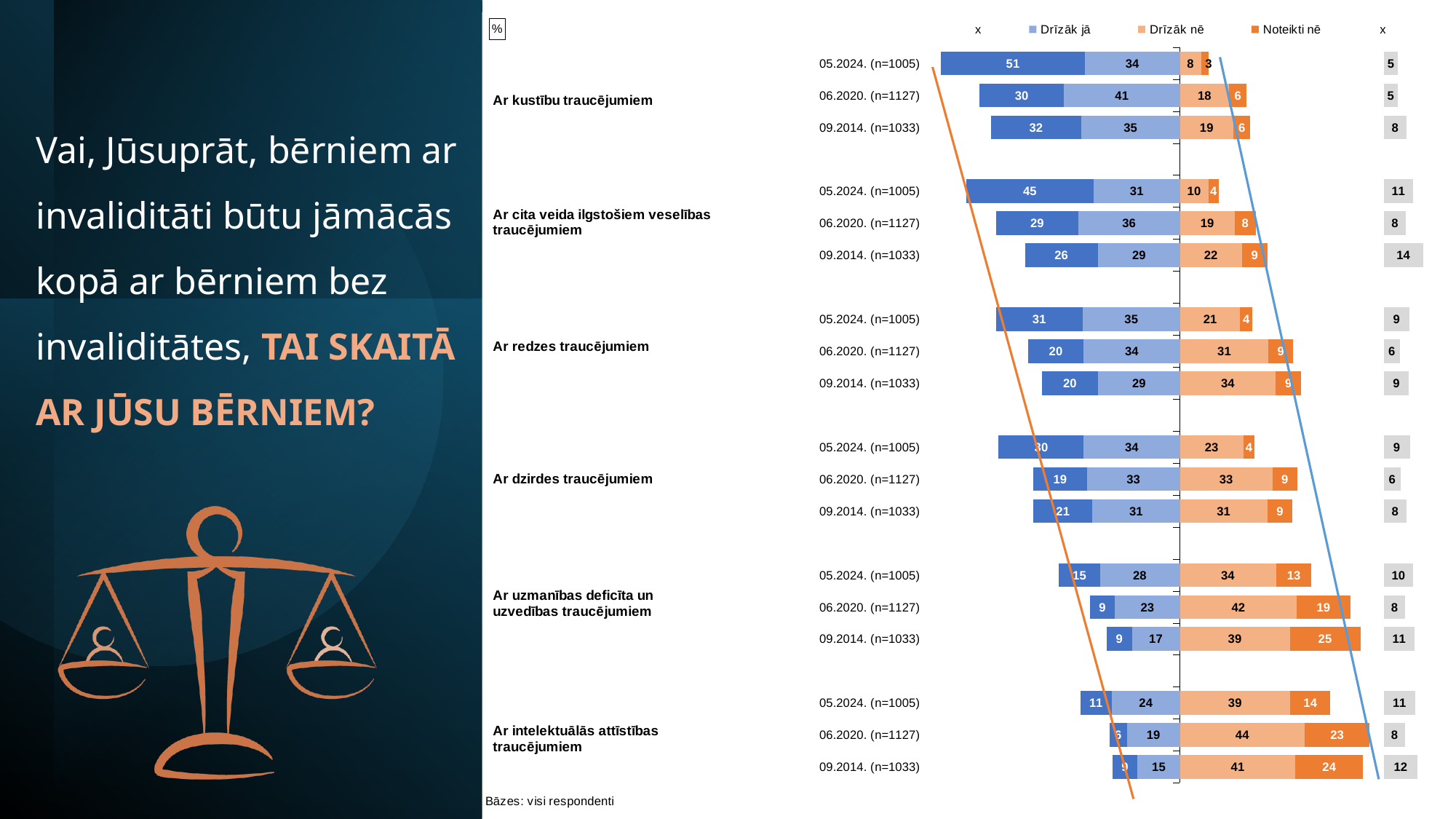
How many survey waves are shown for each disability group? 3 How many disability groups are shown in the chart? 6 What is the difference between the "Drīzāk nē" values for "Ar redzes traucējumiem" in 09.2014 and 05.2024? 13 What is the "Drīzāk nē" value for "Ar dzirdes traucējumiem" in 09.2014? 31 What is the combined "Drīzāk nē" and "Noteikti nē" value for "Ar uzmanības deficīta un uzvedības traucējumiem" in 06.2020? 61 What is the "Noteikti nē" value for "Ar intelektuālās attīstības traucējumiem" in 06.2020? 23 What kind of chart is shown on the slide? bar chart Which disability group has the lowest "Noteikti nē" value in 05.2024? Ar kustību traucējumiem For "Ar kustību traucējumiem", is the "Drīzāk jā" value larger in 06.2020 or in 09.2014? 06.2020 What is the "Drīzāk jā" value for "Ar kustību traucējumiem" in 05.2024? 34 Which disability group has the highest "Noteikti nē" value in 09.2014? Ar uzmanības deficīta un uzvedības traucējumiem For "Ar intelektuālās attīstības traucējumiem", does the "Noteikti nē" value rise or fall from 09.2014 to 05.2024? fall